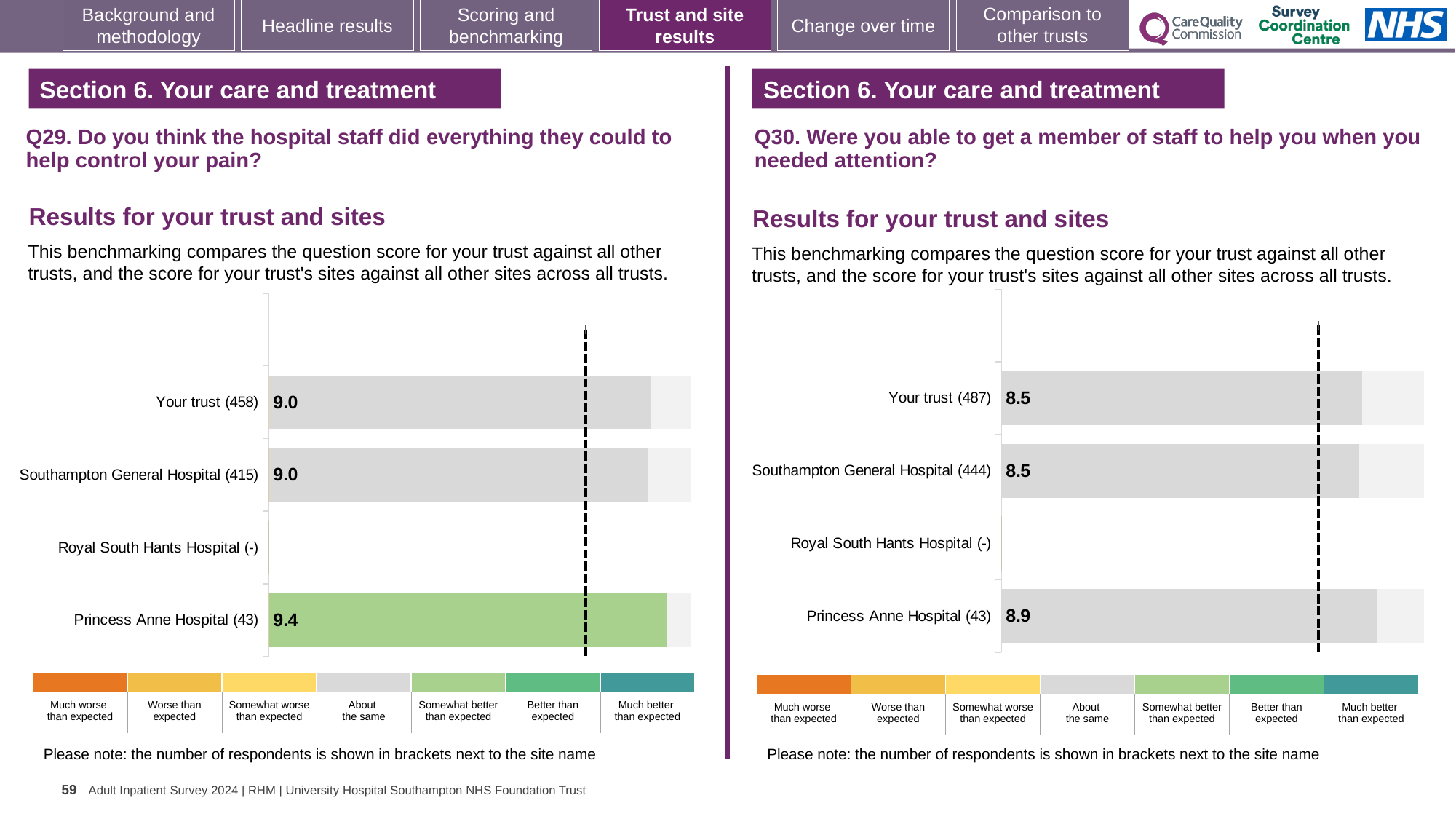
On the Q30 chart (right), how many respondents are shown for Your trust? 487 On the Q30 chart (right), what is the difference between the scores for Princess Anne Hospital and Your trust? 0.4 On the Q29 chart (left), how many respondents are shown for Your trust? 458 On the Q29 chart (left), what is the difference between the scores for Princess Anne Hospital and Southampton General Hospital? 0.4 On the Q29 chart (left), what is the score for Your trust? 9.0 On the Q29 chart (left), what is the score for Princess Anne Hospital? 9.4 On the Q30 chart (right), what is the score for Southampton General Hospital? 8.5 On the Q30 chart (right), which is larger, the score for Princess Anne Hospital or the score for Your trust? Princess Anne Hospital On the Q30 chart (right), what is the score for Princess Anne Hospital? 8.9 On the Q29 chart (left), which site has the highest score? Princess Anne Hospital What kind of chart is used on the Q29 chart (left)? Bar chart On the Q29 chart (left), which benchmark category does the green bar for Princess Anne Hospital indicate? Somewhat better than expected